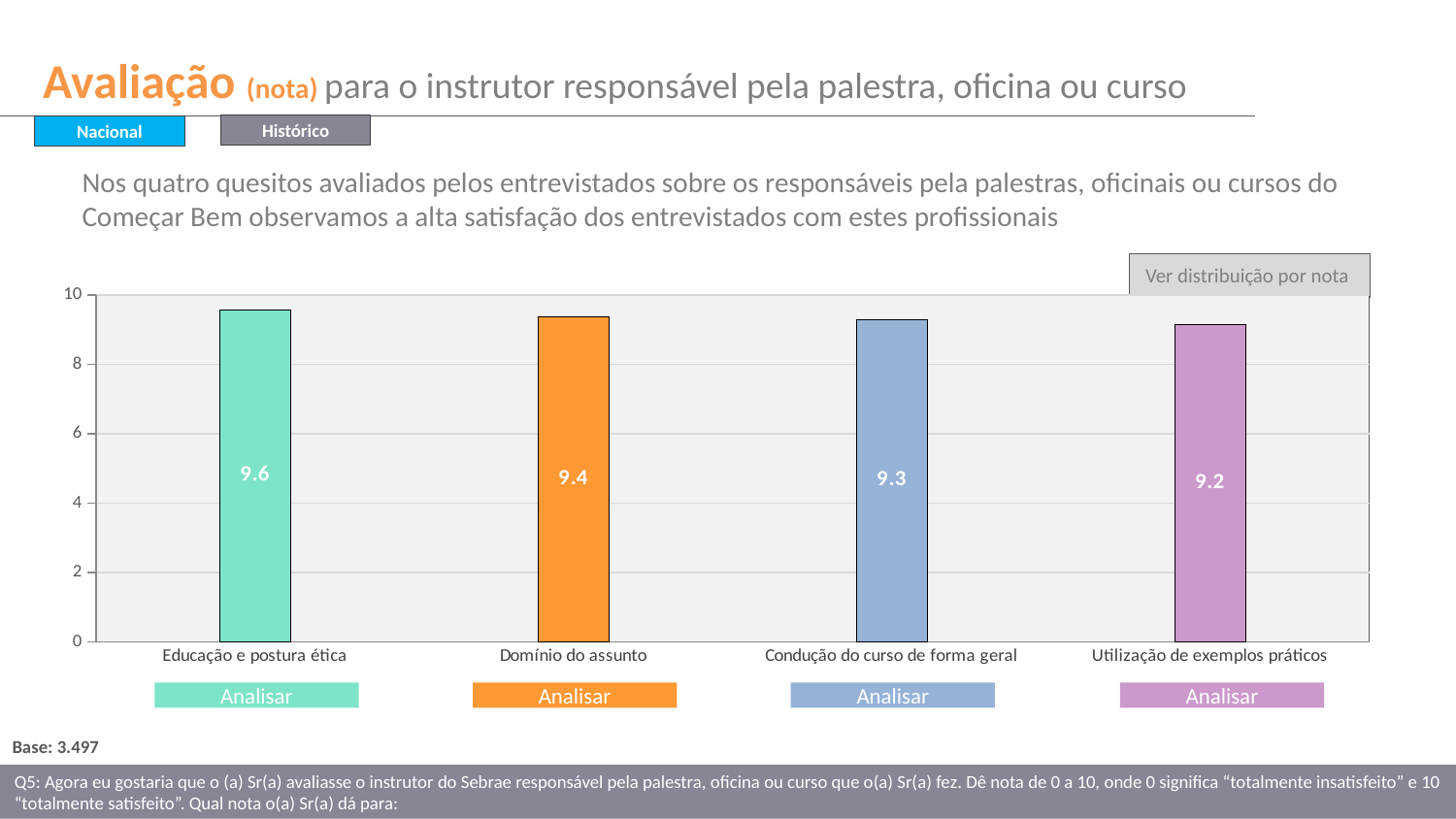
Do the values rise or fall from left to right along the x axis? Fall What is the difference between the values for Educação e postura ética and Utilização de exemplos práticos? 0.4 What is the value for Utilização de exemplos práticos? 9.2 Which is larger, the value for Domínio do assunto or the value for Condução do curso de forma geral? Domínio do assunto What is the value for Domínio do assunto? 9.4 What is the value for Condução do curso de forma geral? 9.3 What kind of chart is shown on the slide? Bar chart Which category has the lowest value? Utilização de exemplos práticos How many categories are shown in the chart? 4 What is the value for Educação e postura ética? 9.6 Is the value for Utilização de exemplos práticos greater or less than 8? greater Which category has the highest value? Educação e postura ética